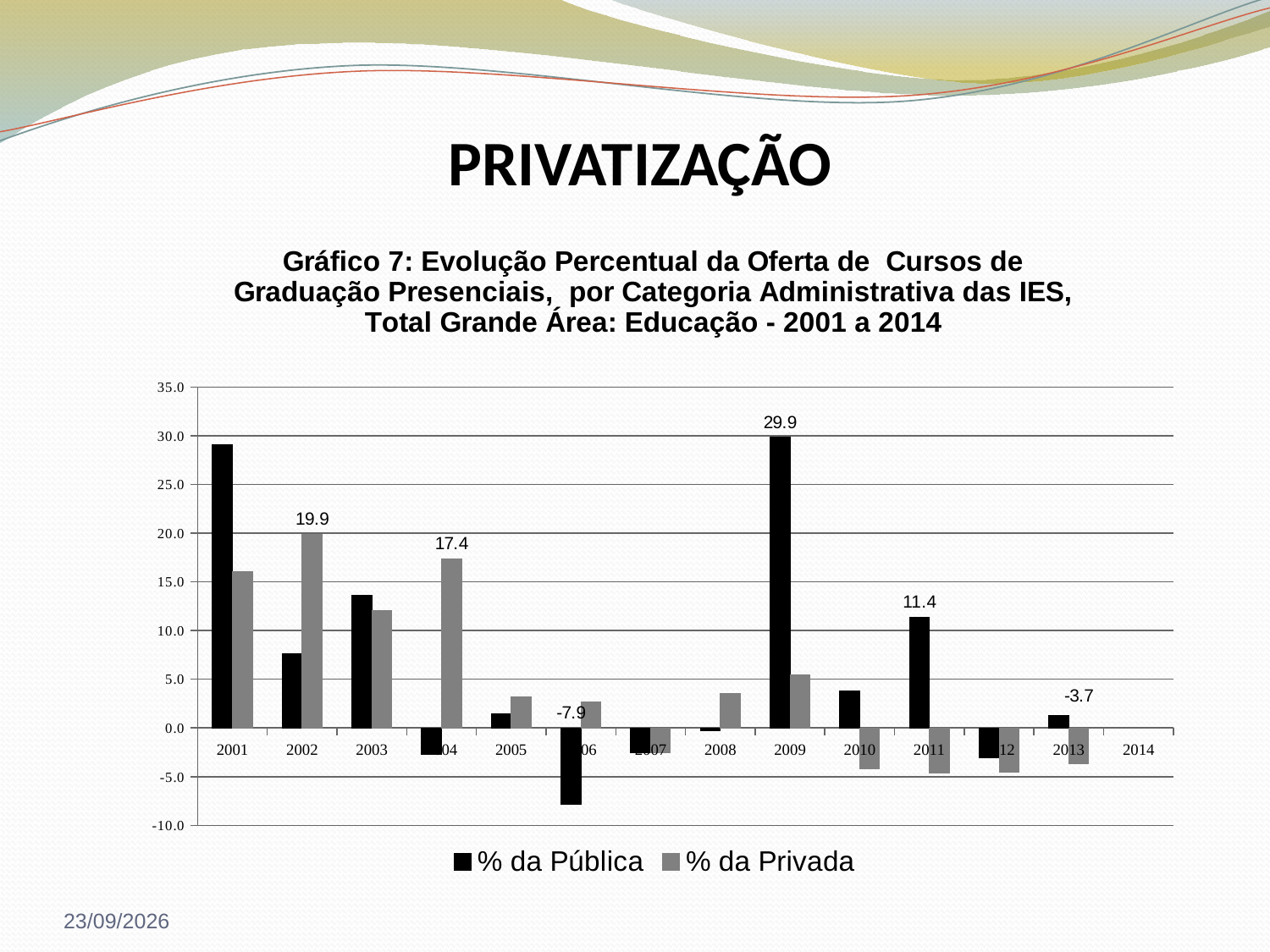
What is the value of % da Pública for 2006? -7.9 In 2002, which is larger: % da Pública or % da Privada? % da Privada What is the value of % da Pública for 2011? 11.4 What is the difference between % da Pública in 2009 and in 2011? 18.5 How many series does the legend list? 2 What kind of chart is shown on the slide? Bar chart In which year is % da Pública highest? 2009 Is the value of % da Pública for 2001 greater or less than 25? greater What is the value of % da Pública for 2009? 29.9 What is the value of % da Privada for 2002? 19.9 What is the value of % da Privada for 2004? 17.4 In which year is % da Pública lowest? 2006